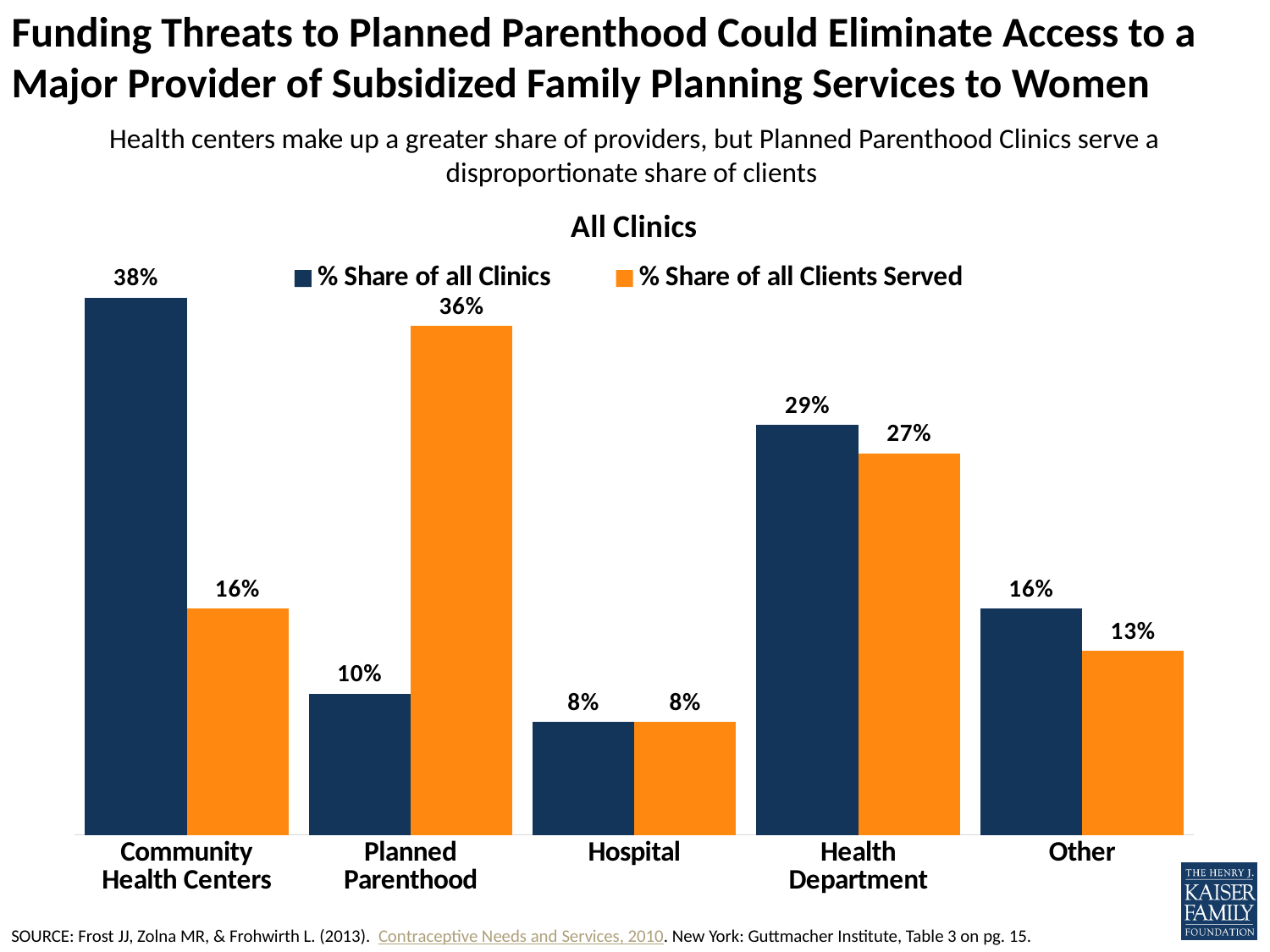
What is the % Share of all Clients Served for Health Department? 27% What kind of chart is shown on the slide? Bar chart What is the % Share of all Clinics for Other? 16% How many categories are shown on the x axis? 5 What is the difference between the % Share of all Clients Served and the % Share of all Clinics for Planned Parenthood? 26% What is the % Share of all Clients Served for Planned Parenthood? 36% What is the title of the chart? All Clinics What is the % Share of all Clinics for Community Health Centers? 38% Which category has the highest % Share of all Clients Served? Planned Parenthood Which category has the lowest % Share of all Clinics? Hospital How many series does the legend list? 2 For Community Health Centers, which is larger: % Share of all Clinics or % Share of all Clients Served? % Share of all Clinics